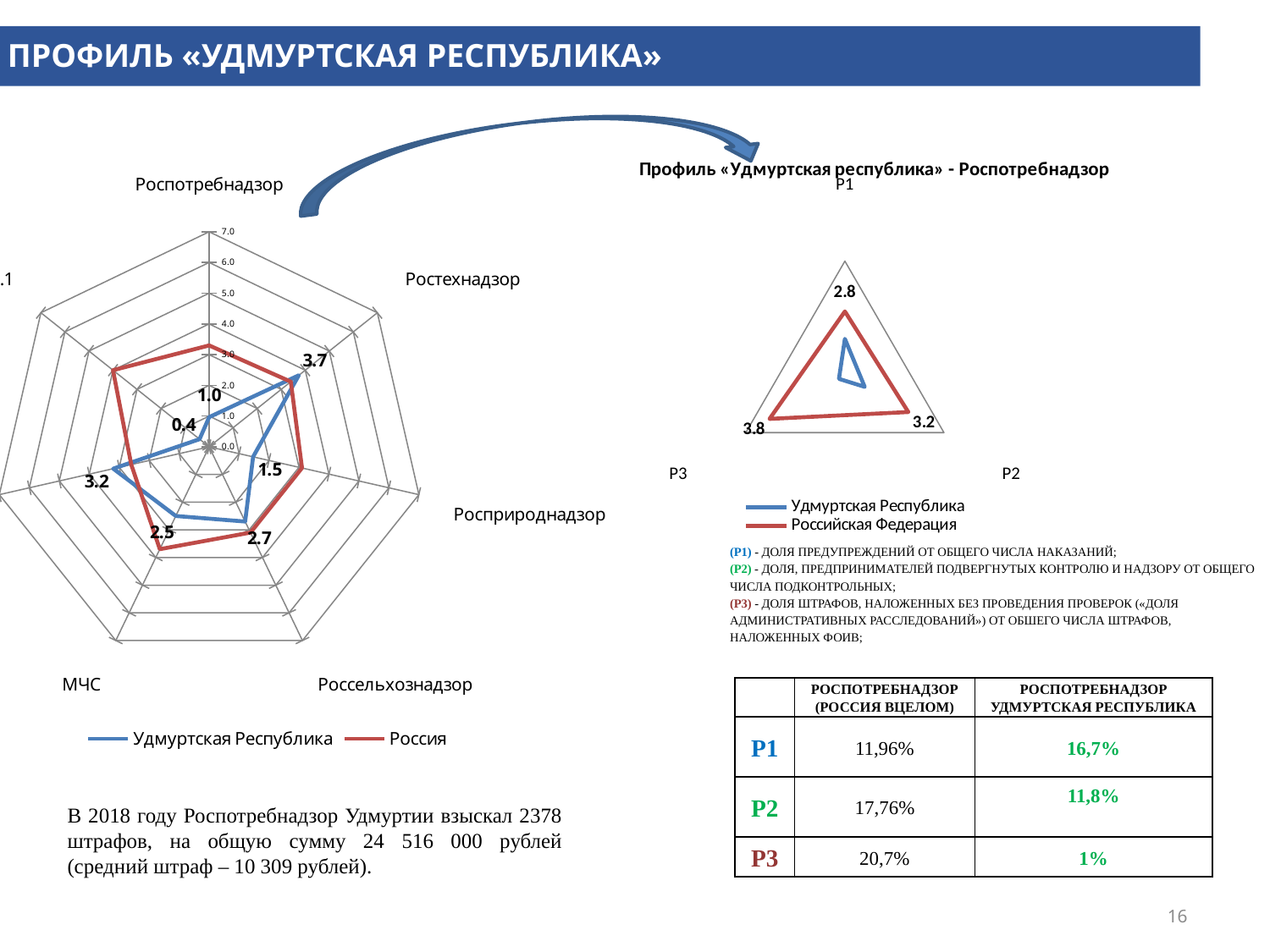
What is the maximum tick value on the radial axis of the left chart? 7.0 In the chart titled «Профиль «Удмуртская республика» - Роспотребнадзор», what is the value for Российская Федерация at P1? 2.8 In the chart titled «Профиль «Удмуртская республика» - Роспотребнадзор», on which axis does Российская Федерация have its lowest value? P1 How many series does the legend of the chart titled «Профиль «Удмуртская республика» - Роспотребнадзор» list? 2 In the chart titled «Профиль «Удмуртская республика» - Роспотребнадзор», what is the difference between the Российская Федерация values at P3 and P1? 1.0 What kind of chart is the large chart on the left of the slide? Radar chart How many series does the legend of the left chart list? 2 In the chart titled «Профиль «Удмуртская республика» - Роспотребнадзор», what is the value for Российская Федерация at P3? 3.8 In the chart titled «Профиль «Удмуртская республика» - Роспотребнадзор», which series has the larger value at P2, Удмуртская Республика or Российская Федерация? Российская Федерация In the chart titled «Профиль «Удмуртская республика» - Роспотребнадзор», what is the value for Российская Федерация at P2? 3.2 How many axes (categories) does the large radar chart on the left have? 7 In the chart titled «Профиль «Удмуртская республика» - Роспотребнадзор», on which axis does Российская Федерация have its highest value? P3